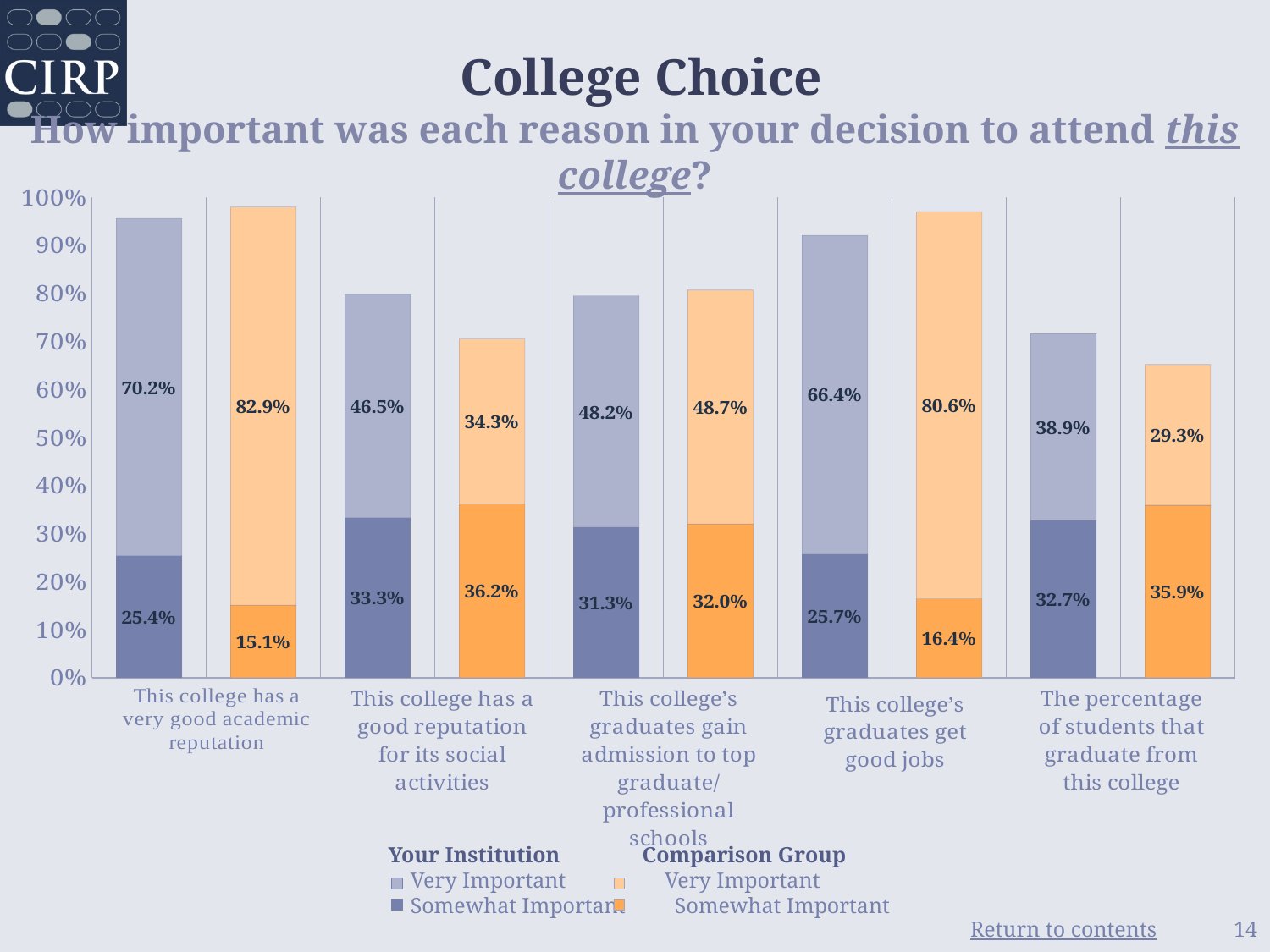
What is the total (Very Important plus Somewhat Important) for Your Institution on 'This college has a good reputation for its social activities'? 79.8% What percentage of students at Your Institution rated 'This college has a very good academic reputation' as Very Important? 70.2% For 'This college has a good reputation for its social activities', which is larger: the Very Important percentage for Your Institution or for the Comparison Group? Your Institution What percentage of the Comparison Group rated 'This college's graduates get good jobs' as Somewhat Important? 16.4% Which reason has the lowest Very Important percentage for Your Institution? The percentage of students that graduate from this college What percentage of students at Your Institution rated 'The percentage of students that graduate from this college' as Somewhat Important? 32.7% Which reason has the highest Very Important percentage for the Comparison Group? This college has a very good academic reputation How many series does the legend list? 4 What is the total (Very Important plus Somewhat Important) for the Comparison Group on 'The percentage of students that graduate from this college'? 65.2% How many reasons (categories) are shown on the x axis of the chart? 5 What is the difference between the Comparison Group and Your Institution Very Important percentages for 'This college's graduates get good jobs'? 14.2% What kind of chart is shown on the slide? Stacked bar chart